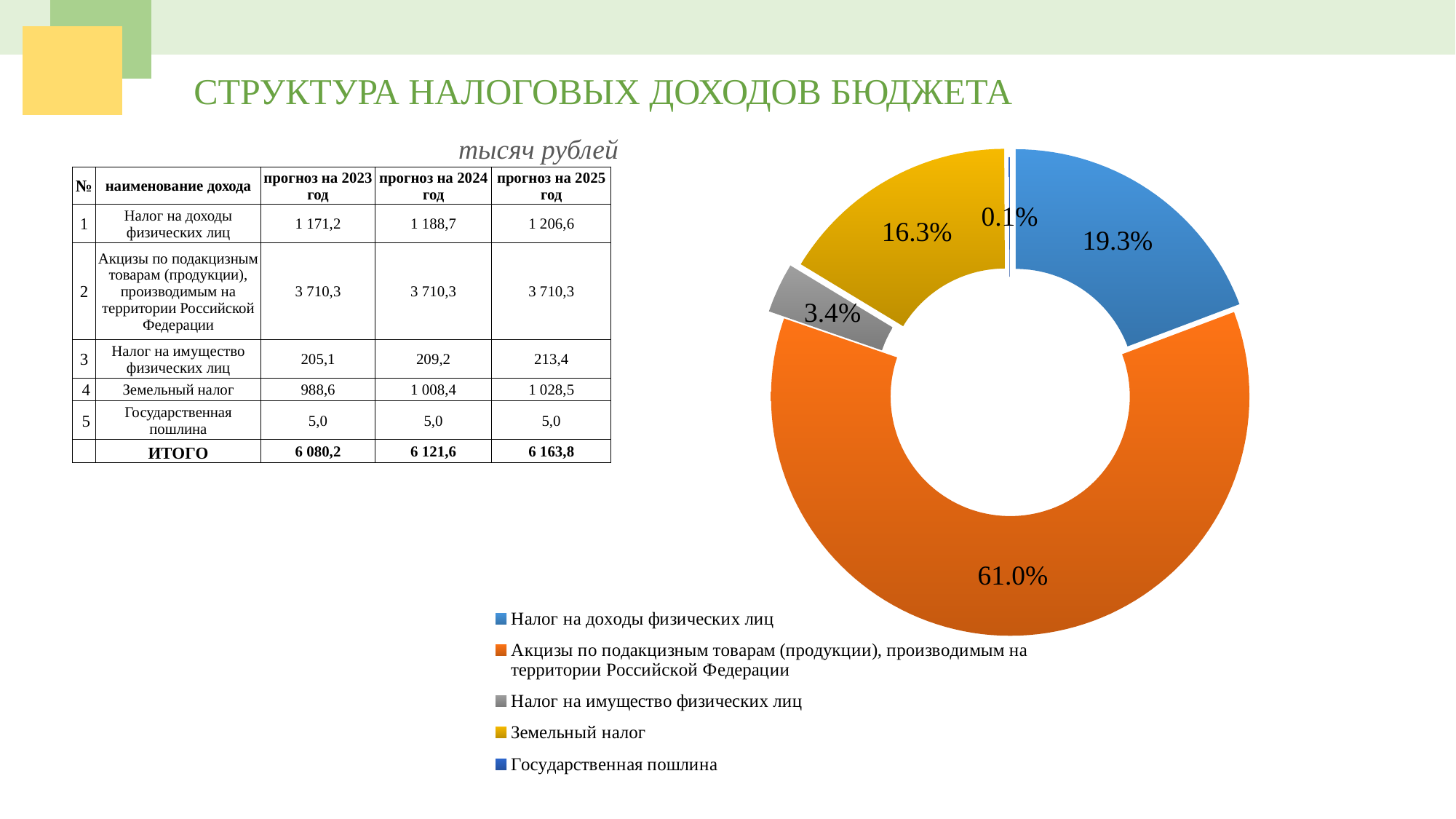
In the doughnut chart, which is larger: the share of "Налог на доходы физических лиц" or the share of "Земельный налог"? Налог на доходы физических лиц What is the difference in percentage points between the share of "Налог на доходы физических лиц" and the share of "Земельный налог" in the doughnut chart? 3.0 percentage points What share of the doughnut chart does "Акцизы по подакцизным товарам (продукции), производимым на территории Российской Федерации" have? 61.0% What share of the doughnut chart does "Налог на имущество физических лиц" have? 3.4% What share of the doughnut chart does "Налог на доходы физических лиц" have? 19.3% What share of the doughnut chart does "Земельный налог" have? 16.3% What colour is the slice for "Налог на имущество физических лиц" in the doughnut chart? Gray How many categories does the legend of the doughnut chart list? 5 What share of the doughnut chart does "Государственная пошлина" have? 0.1% Which category has the smallest share in the doughnut chart? Государственная пошлина Which category has the largest share in the doughnut chart? Акцизы по подакцизным товарам (продукции), производимым на территории Российской Федерации What kind of chart is shown on the slide? Doughnut (pie) chart